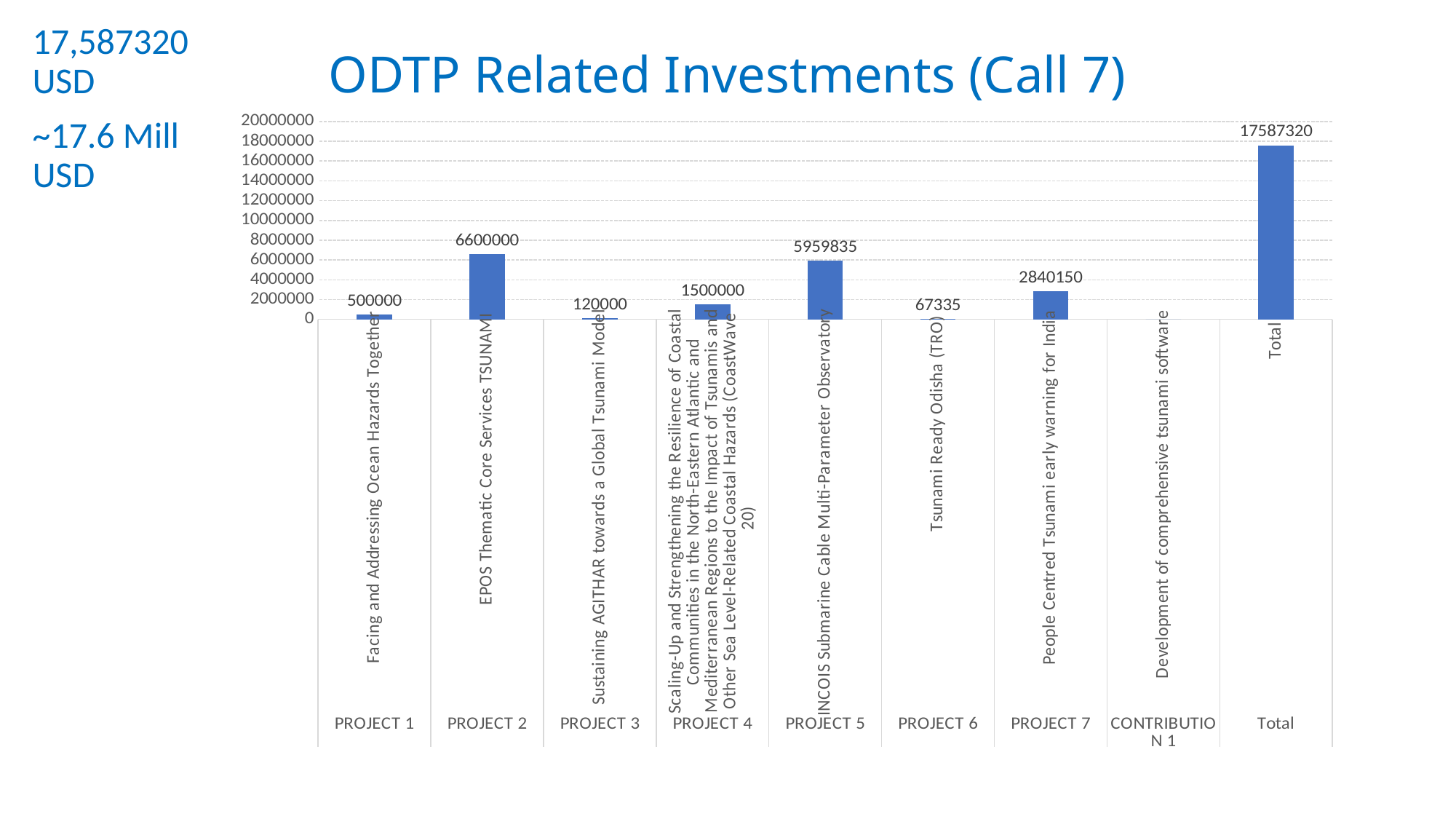
What is the value for PROJECT 5 (INCOIS Submarine Cable Multi-Parameter Observatory)? 5959835 What is the value shown for the Total bar? 17587320 Is the value for PROJECT 2 greater or less than 6000000? greater What kind of chart is shown on the slide? bar chart What is the title of the chart? ODTP Related Investments (Call 7) Which is larger, the value for PROJECT 4 or the value for PROJECT 7? PROJECT 7 Among the labelled projects, which has the lowest investment? PROJECT 6 What is the value for PROJECT 2 (EPOS Thematic Core Services TSUNAMI)? 6600000 How many categories are shown on the x axis of the chart? 9 Excluding the Total bar, which project has the highest investment? PROJECT 2 What is the value for PROJECT 7 (People Centred Tsunami early warning for India)? 2840150 What is the difference between the values for PROJECT 2 and PROJECT 5? 640165